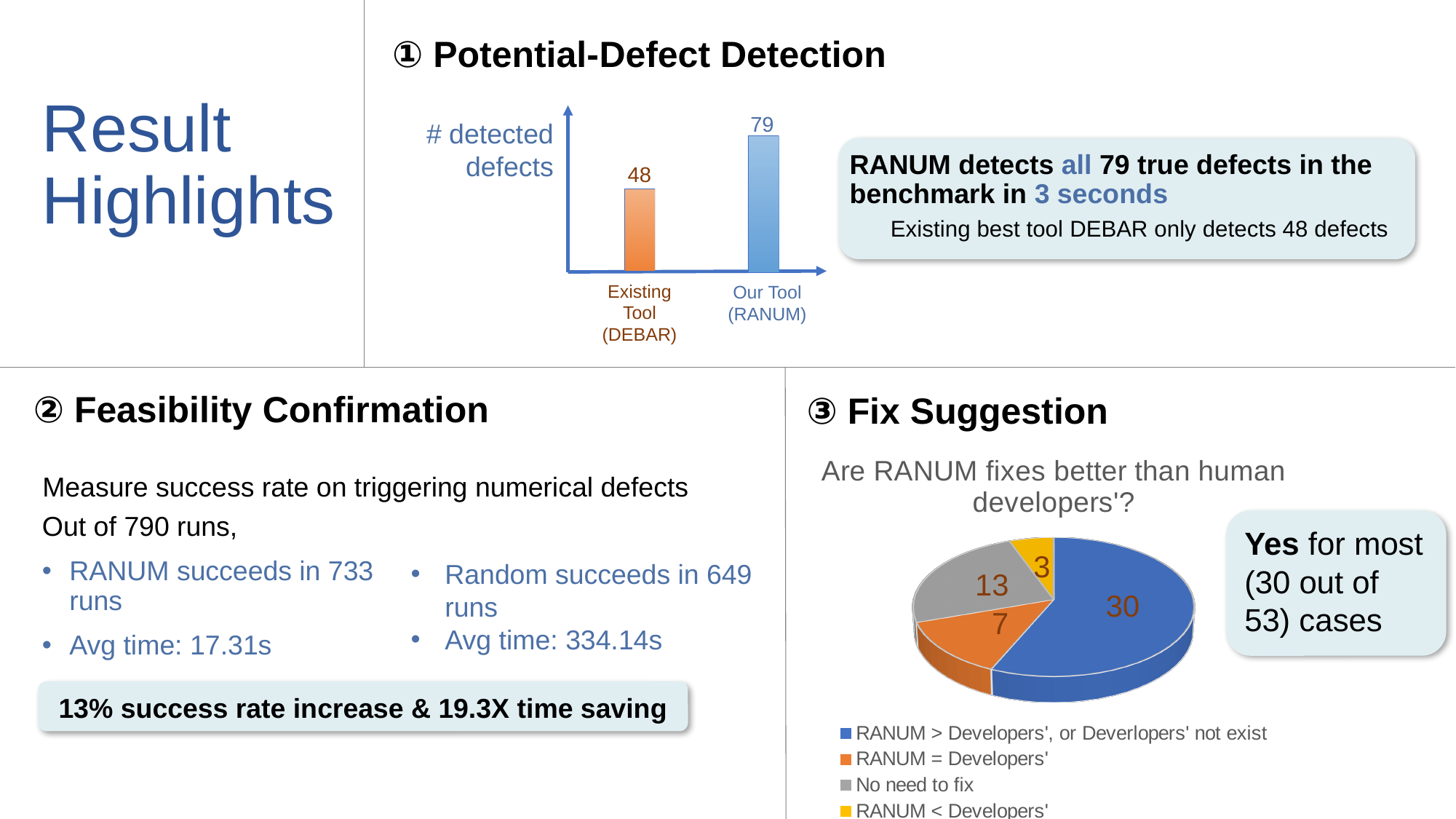
In the Fix Suggestion pie chart, is the 'RANUM = Developers'' slice larger or smaller than the 'No need to fix' slice? Smaller In the Fix Suggestion pie chart, what is the total of all slice values? 53 In the Potential-Defect Detection bar chart, which tool has the higher number of detected defects? Our Tool (RANUM) In the Fix Suggestion pie chart, what is the value for the 'RANUM > Developers', or Deverlopers' not exist' slice? 30 In the Potential-Defect Detection bar chart, what is the difference in detected defects between Our Tool (RANUM) and the Existing Tool (DEBAR)? 31 What kind of chart is used in the Potential-Defect Detection section? Bar chart In the Fix Suggestion pie chart, what is the value for the 'No need to fix' slice? 13 How many bars are shown in the Potential-Defect Detection bar chart? 2 In the Potential-Defect Detection bar chart, how many defects does Our Tool (RANUM) detect? 79 How many categories does the legend of the Fix Suggestion pie chart list? 4 In the Fix Suggestion pie chart, which category has the smallest slice? RANUM < Developers' In the Potential-Defect Detection bar chart, how many defects does the Existing Tool (DEBAR) detect? 48